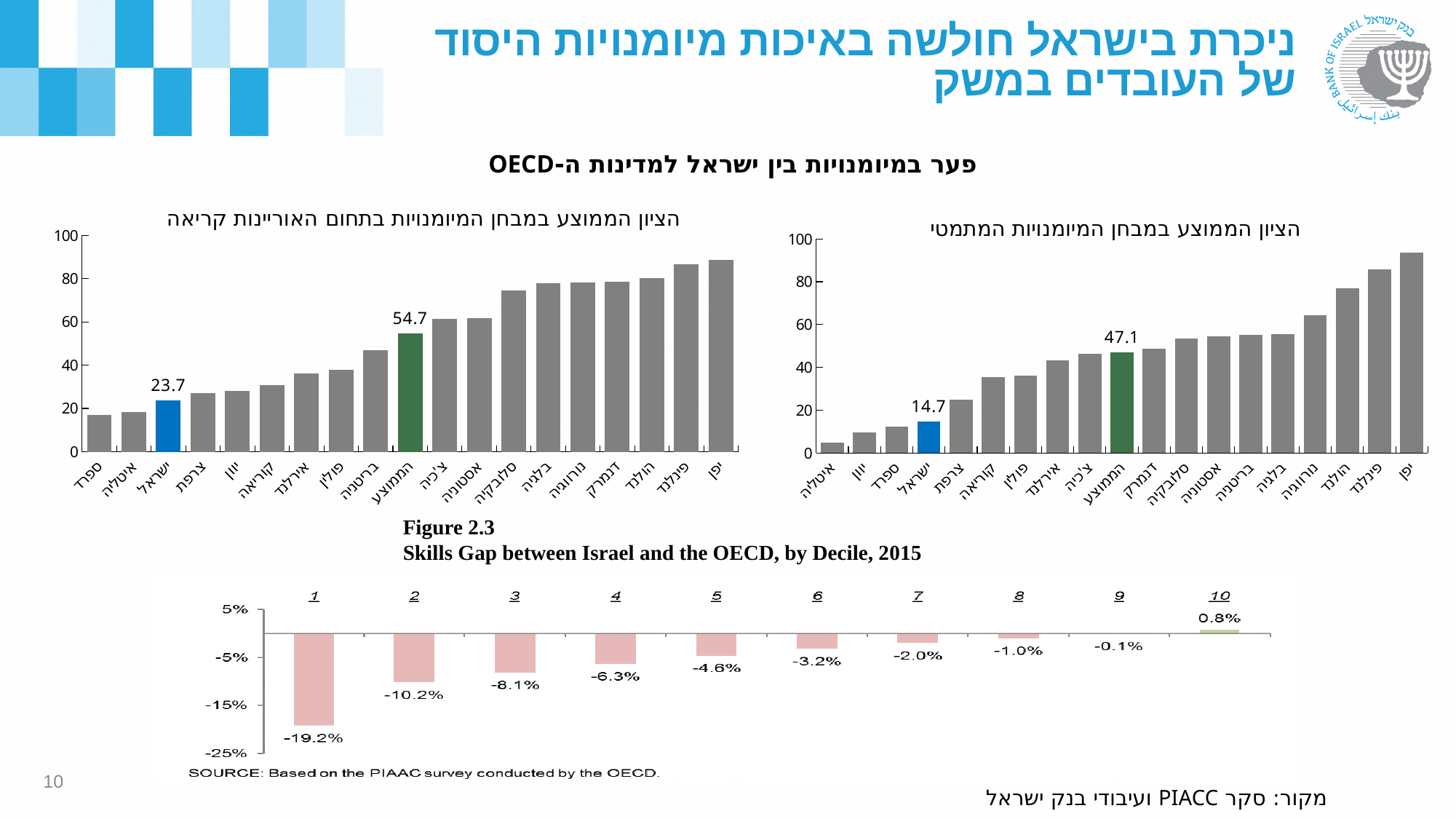
In the bottom chart 'Skills Gap between Israel and the OECD, by Decile, 2015', do the values rise or fall from decile 1 to decile 10? rise In the bottom chart 'Skills Gap between Israel and the OECD, by Decile, 2015', how many deciles are shown? 10 In the bottom chart 'Skills Gap between Israel and the OECD, by Decile, 2015', which decile has the lowest value? 1 In the left chart (reading literacy average score), what is the value labelled for ישראל (Israel)? 23.7 What type of chart is the left chart (reading literacy average score)? bar chart In the bottom chart 'Skills Gap between Israel and the OECD, by Decile, 2015', what is the value for decile 10? 0.8% In the bottom chart 'Skills Gap between Israel and the OECD, by Decile, 2015', what is the difference between the values for decile 2 and decile 3? 2.1 percentage points In the bottom chart 'Skills Gap between Israel and the OECD, by Decile, 2015', what is the value for decile 1? -19.2% In the left chart (reading literacy average score), what is the value labelled for הממוצע (the average)? 54.7 In the right chart (mathematical literacy average score), what is the value labelled for ישראל (Israel)? 14.7 In the right chart (mathematical literacy average score), what is the difference between the average (הממוצע) and Israel (ישראל)? 32.4 In the right chart (mathematical literacy average score), which country has the highest bar? יפן